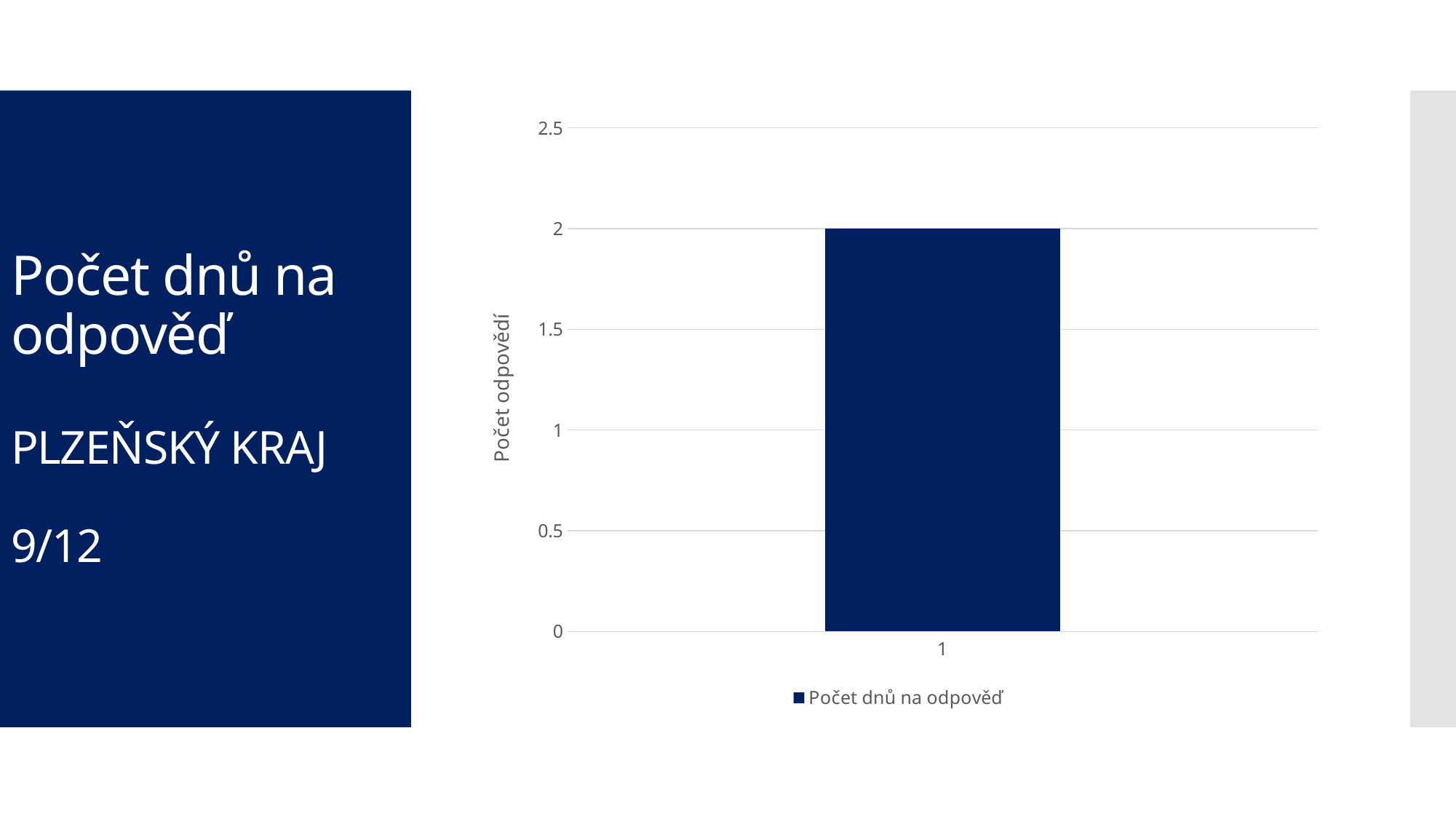
What kind of chart is shown on the slide? bar chart What is the category label shown on the horizontal axis? 1 What series name is shown in the legend? Počet dnů na odpověď What is the value of the bar for category 1? 2 How many bars are plotted in the chart? 1 What is the label on the vertical axis? Počet odpovědí Is the value for category 1 greater or less than 2.5? less Is the value for category 1 greater or less than 1.5? greater What is the highest value shown on the vertical axis? 2.5 How many series does the legend list? 1